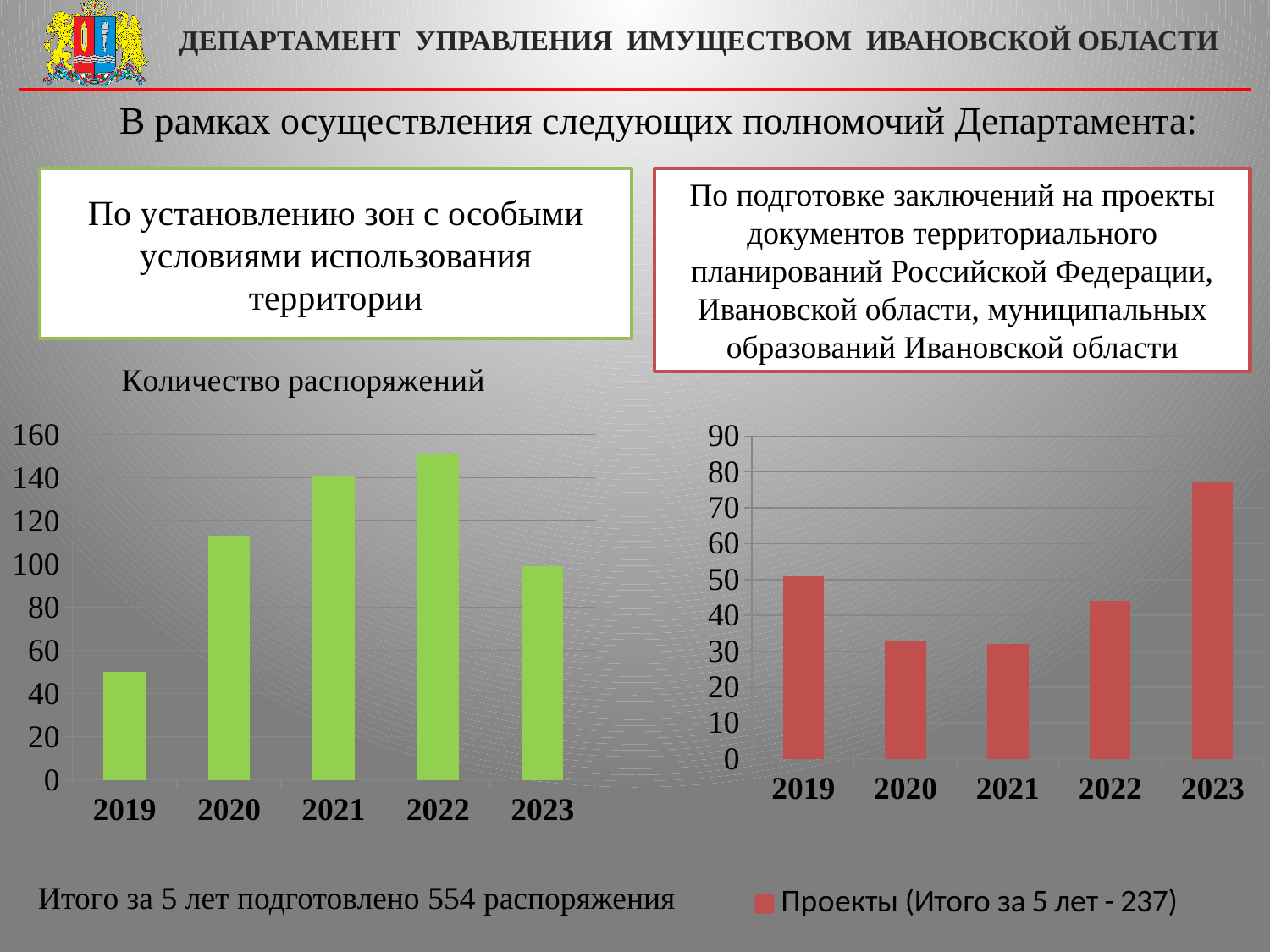
In the left chart "Количество распоряжений", which year has the larger value, 2021 or 2023? 2021 In the right chart (red bars), is the value for 2019 greater or less than 40? greater What kind of chart is the left chart titled "Количество распоряжений"? bar chart In the left chart "Количество распоряжений", which year has the highest bar? 2022 In the right chart (red bars), which year has the larger value, 2019 or 2022? 2019 In the right chart (red bars), which year has the highest bar? 2023 In the right chart (red bars), is the value for 2022 greater or less than 50? less What is the legend entry shown below the right chart (red bars)? Проекты (Итого за 5 лет - 237) In the left chart "Количество распоряжений", is the value for 2020 greater or less than 100? greater How many years are shown on the x axis of the left chart "Количество распоряжений"? 5 In the left chart "Количество распоряжений", which year has the lowest bar? 2019